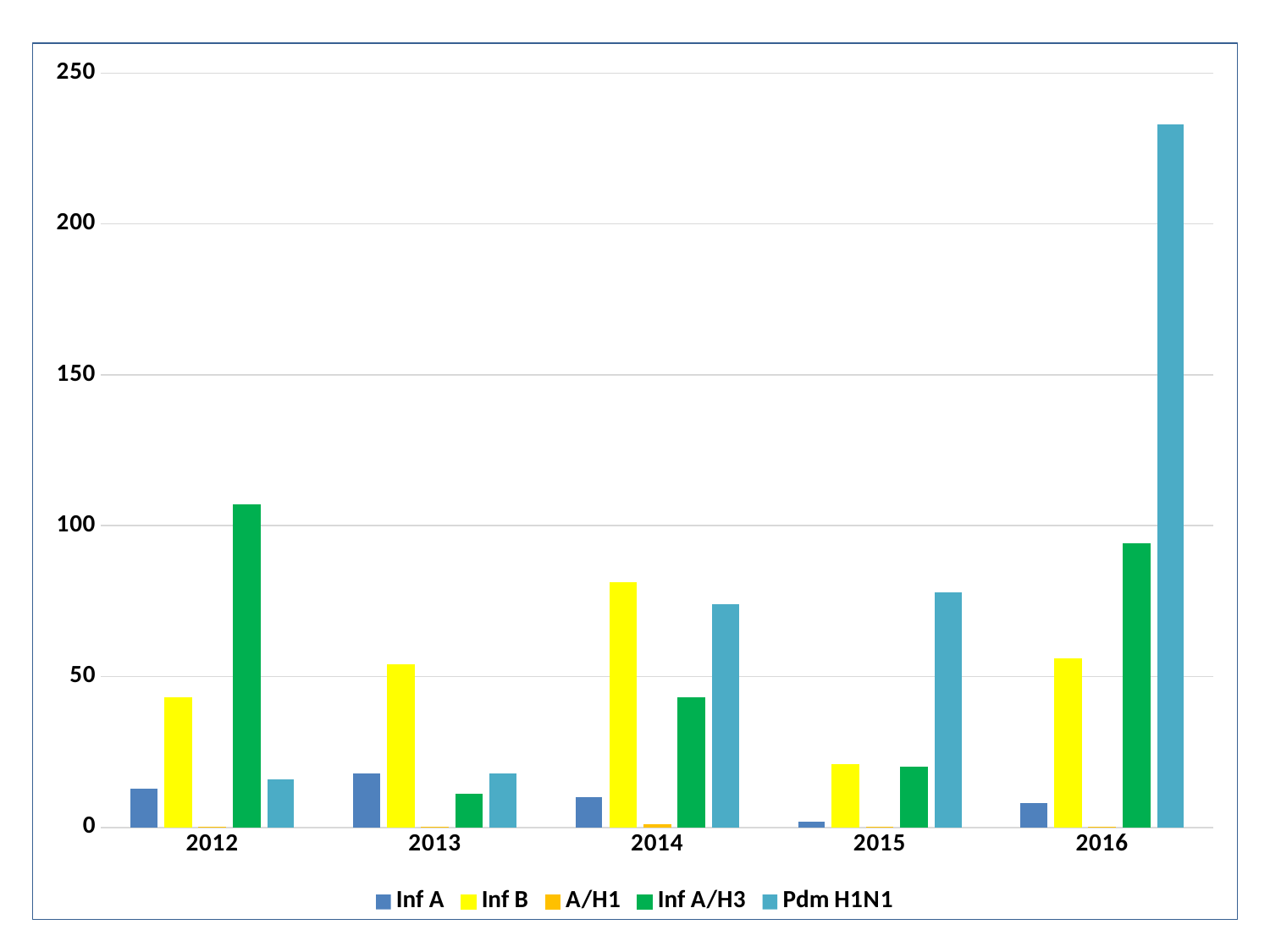
What kind of chart is shown on the slide? bar chart Does the Pdm H1N1 series generally rise or fall from 2012 to 2016? rise How many series does the legend list? 5 In 2014, which is larger: Inf B or Inf A/H3? Inf B Is the value for Inf B in 2013 greater or less than 50? greater Which series has the tallest bar in 2012? Inf A/H3 Is the value for Inf A/H3 in 2012 greater or less than 100? greater Is the value for Pdm H1N1 in 2016 greater or less than 200? greater In which year is the Pdm H1N1 bar the tallest? 2016 In which year is the Inf A bar the shortest? 2015 How many years are shown on the x axis? 5 What colour represents Inf B in the legend? yellow